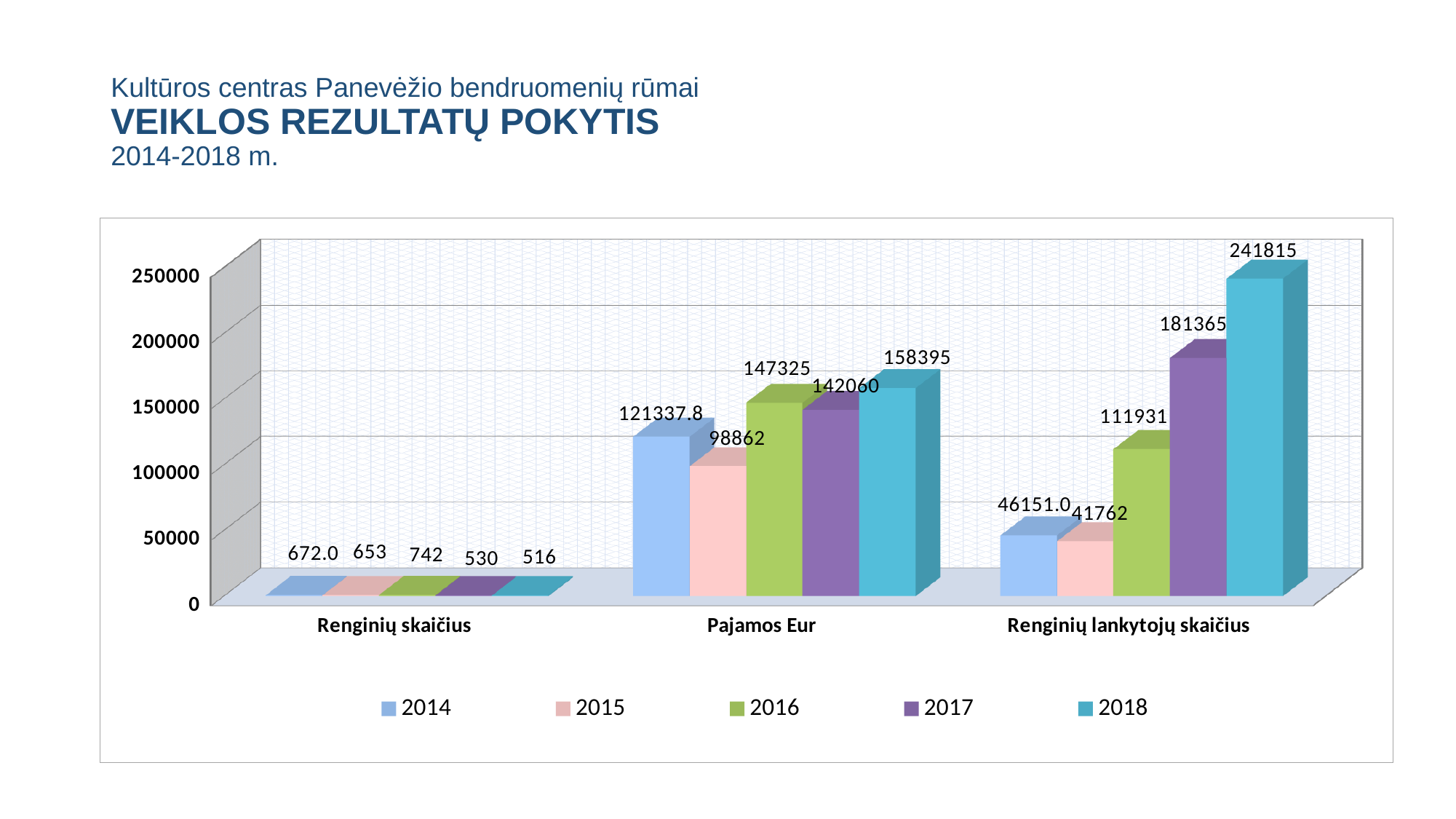
Which year has the highest value in the Pajamos Eur category? 2018 Which year has the lowest value in the Renginių skaičius category? 2018 Do the values in the Renginių lankytojų skaičius category rise or fall from 2016 to 2018? Rise What kind of chart is shown on the slide? Bar chart Is the 2016 value for Renginių lankytojų skaičius greater or less than 100000? greater What is the value for 2016 in the Renginių skaičius category? 742 What is the value for 2018 in the Renginių lankytojų skaičius category? 241815 Which is larger in the Pajamos Eur category: the 2016 value or the 2017 value? 2016 How many series does the legend list? 5 What is the difference between the 2018 and 2017 values in the Renginių lankytojų skaičius category? 60450 What is the value for 2015 in the Pajamos Eur category? 98862 How many categories are shown on the x axis? 3